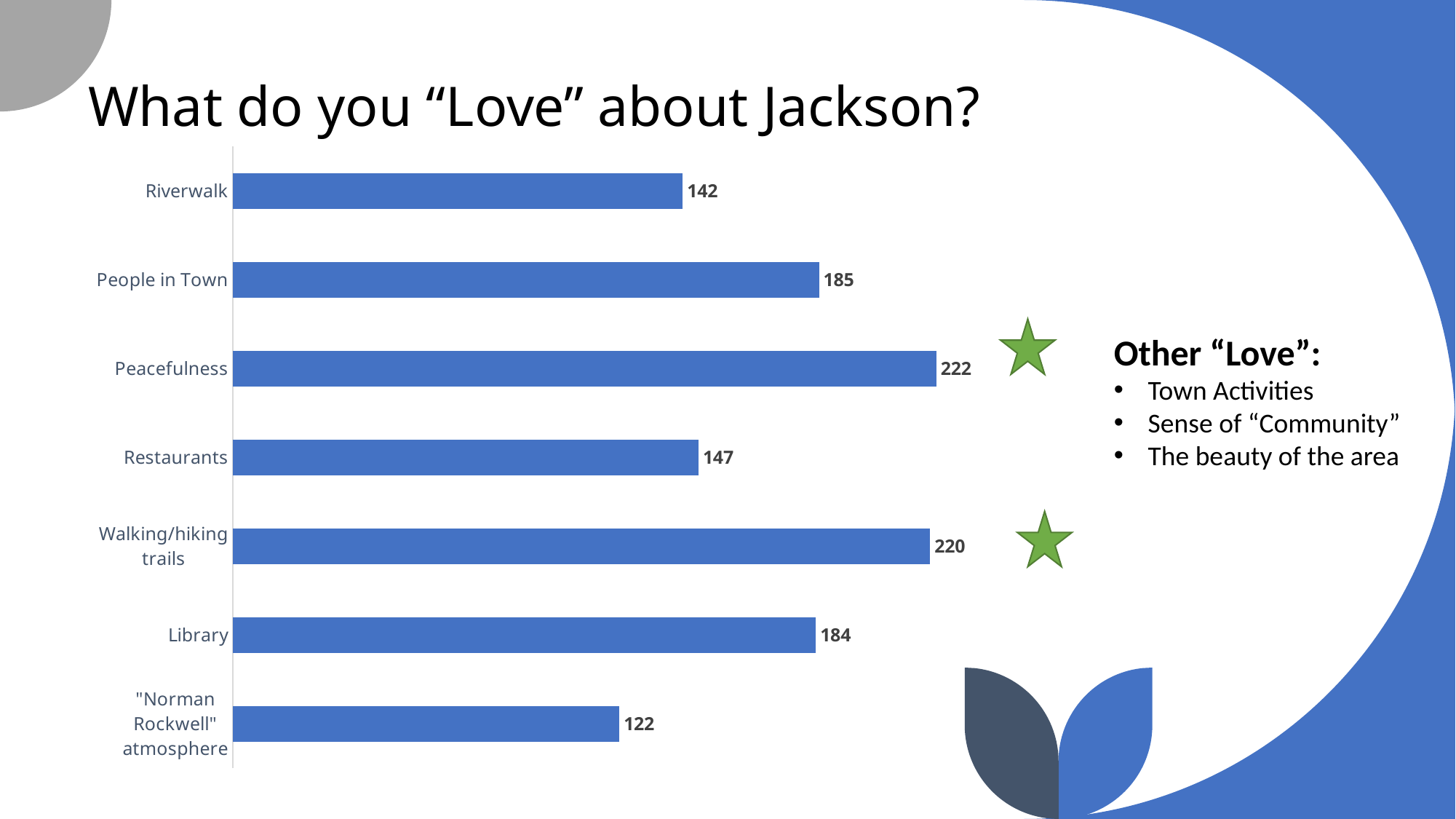
What is the value for Riverwalk? 142 What is the title of the slide containing the chart? What do you "Love" about Jackson? What is the difference between the values for Peacefulness and Walking/hiking trails? 2 What kind of chart is shown on the slide? Bar chart What is the difference between the values for People in Town and Riverwalk? 43 Which is larger, the value for Restaurants or the value for Library? Library How many categories are shown in the chart? 7 Which category has the lowest value? "Norman Rockwell" atmosphere Which category has the highest value? Peacefulness What is the value for Library? 184 What is the value for Peacefulness? 222 How many categories are marked with a green star? 2